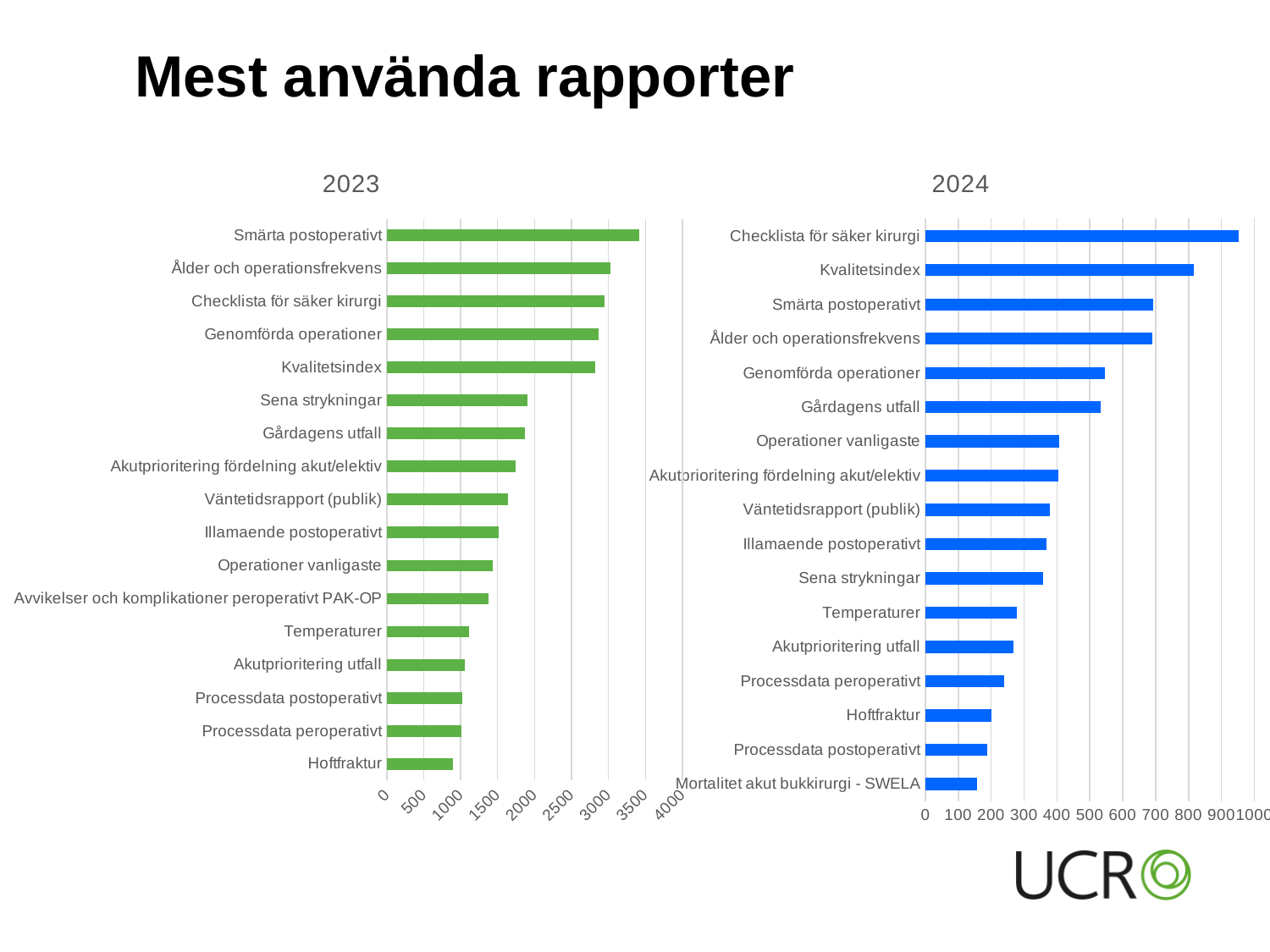
What kind of chart is the 2024 chart? Bar chart On the 2024 chart, is the value for Mortalitet akut bukkirurgi - SWELA greater or less than 200? less What colour are the bars on the 2023 chart? Green On the 2024 chart, is the value for Checklista för säker kirurgi greater or less than 900? greater On the 2024 chart, which report has the highest value? Checklista för säker kirurgi How many reports are listed on the 2023 chart? 17 On the 2023 chart, which report has the highest value? Smärta postoperativt On the 2023 chart, is the value for Hoftfraktur greater or less than 1000? less On the 2024 chart, which report has the lowest value? Mortalitet akut bukkirurgi - SWELA On the 2023 chart, which report has the lowest value? Hoftfraktur On the 2024 chart, which is larger, Checklista för säker kirurgi or Kvalitetsindex? Checklista för säker kirurgi